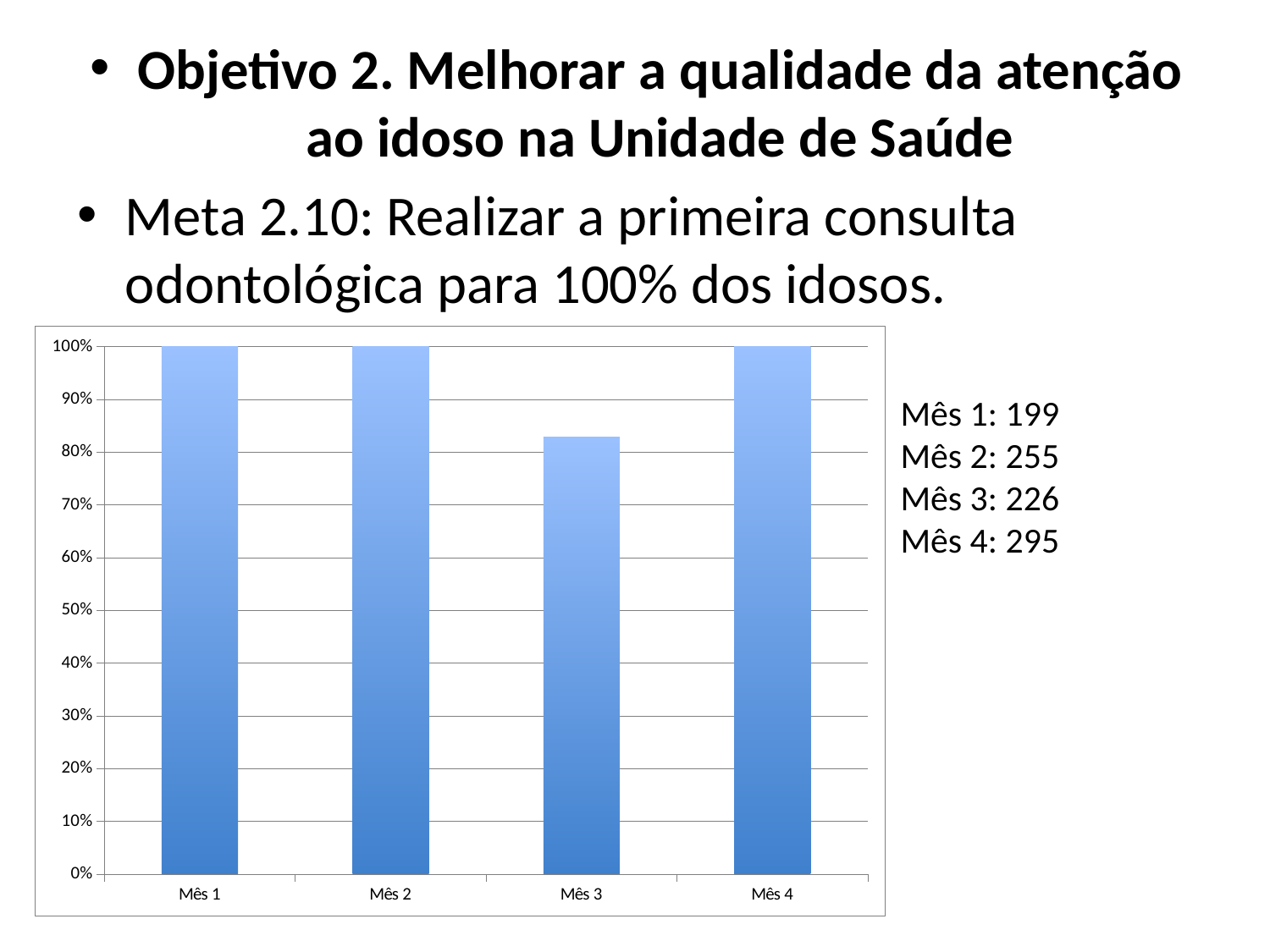
What is the highest value shown on the y axis of the chart? 100% What is the value for Mês 4 in the chart? 100% Which is larger, the value for Mês 3 or the value for Mês 4? Mês 4 Is the value for Mês 3 greater or less than 90%? less What is the value for Mês 1 in the chart? 100% What kind of chart is shown on the slide? bar chart Which month has the lowest value in the chart? Mês 3 Is the value for Mês 3 greater or less than 80%? greater How many categories (months) are plotted on the x axis of the chart? 4 Which is larger, the value for Mês 2 or the value for Mês 3? Mês 2 How many bars in the chart reach 100%? 3 What is the value for Mês 2 in the chart? 100%